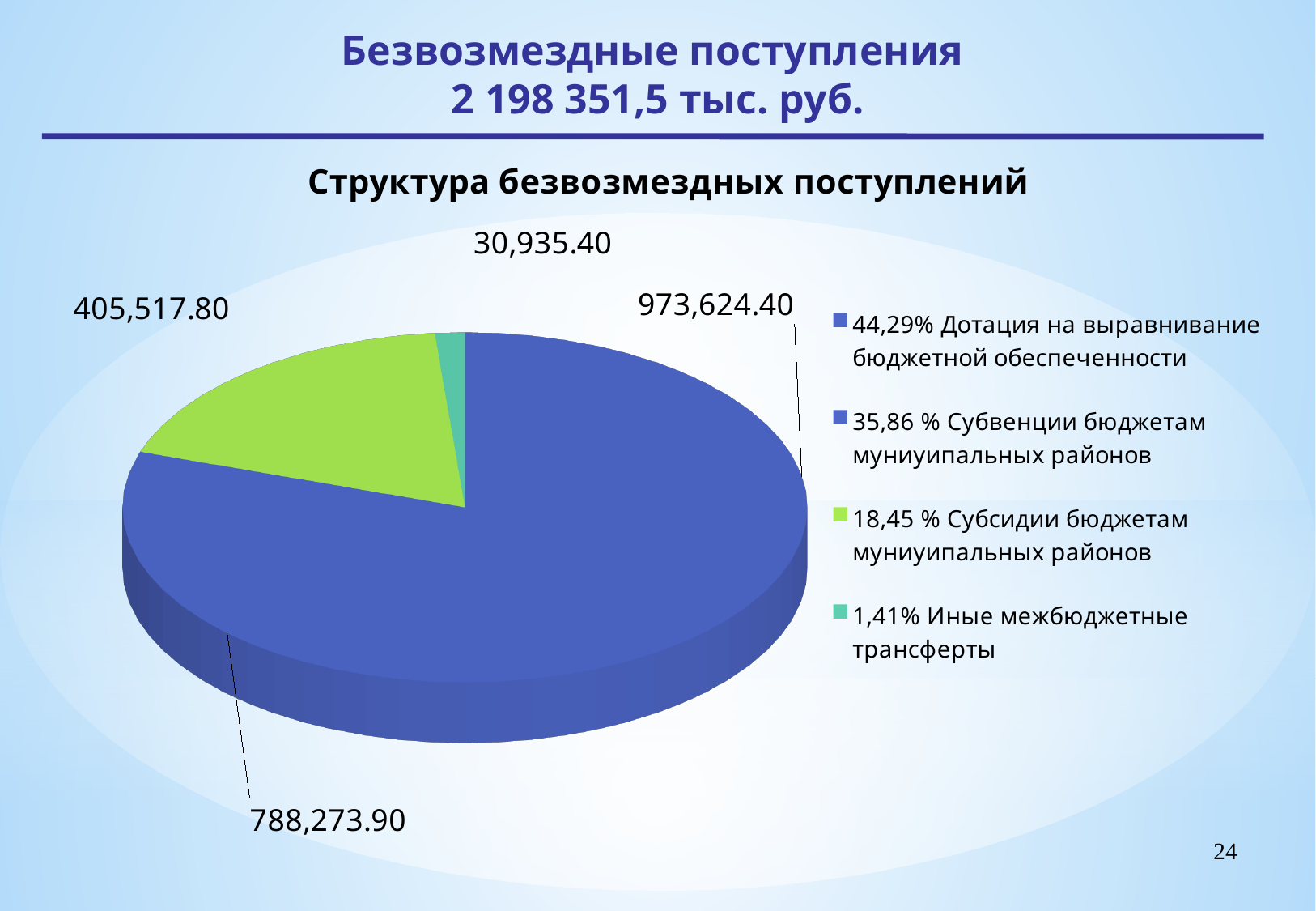
What is the largest data label value shown on the pie chart? 973,624.40 Which category has the smallest share of the pie? Иные межбюджетные трансферты Which category has the largest share of the pie? Дотация на выравнивание бюджетной обеспеченности What is the title of the chart? Структура безвозмездных поступлений What share of the pie does Дотация на выравнивание бюджетной обеспеченности represent? 44,29% What colour is the slice for Субсидии бюджетам муниуипальных районов? green What share of the pie does Субсидии бюджетам муниуипальных районов represent? 18,45 % What kind of chart is shown on the slide? pie chart What share of the pie does Иные межбюджетные трансферты represent? 1,41% What is the smallest data label value shown on the pie chart? 30,935.40 How many slices does the pie chart have? 4 How many entries does the chart legend list? 4